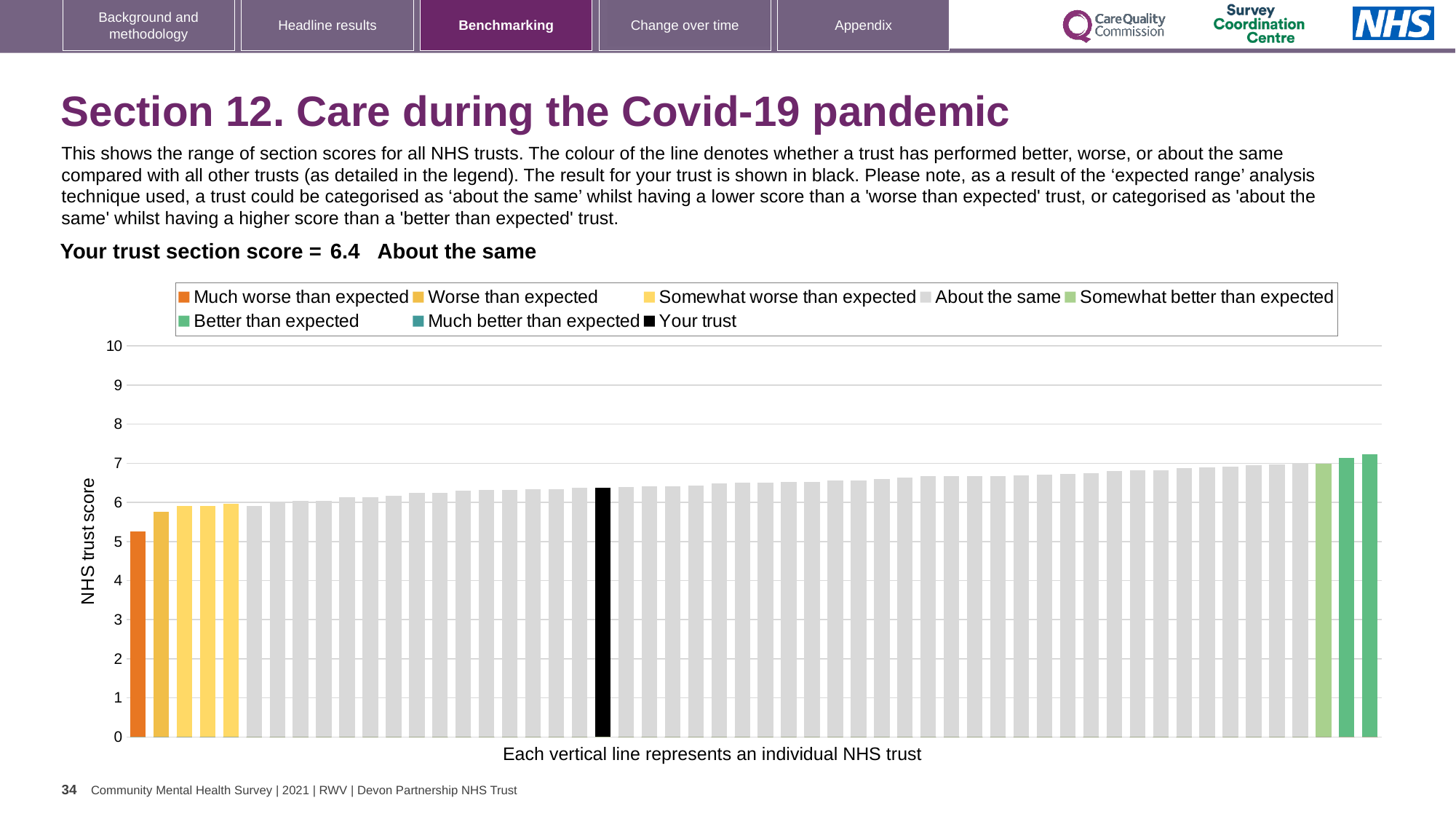
Which performance category is your trust placed in for this section? About the same How many entries does the chart legend list? 8 What is the label on the vertical axis of the chart? NHS trust score How many bars are coloured as 'Better than expected'? 2 Is the value of the black 'Your trust' bar greater or less than 6? greater What kind of chart is shown on the slide? bar chart Is the value of the lowest bar (the orange 'Much worse than expected' trust) greater or less than 6? less Which legend category does the highest bar on the chart belong to? Better than expected Is the value of the highest bar on the chart greater or less than 7? greater What is the section score for your trust? 6.4 Which legend category does the lowest bar on the chart belong to? Much worse than expected Do the bar values rise or fall moving from left to right along the x axis? rise